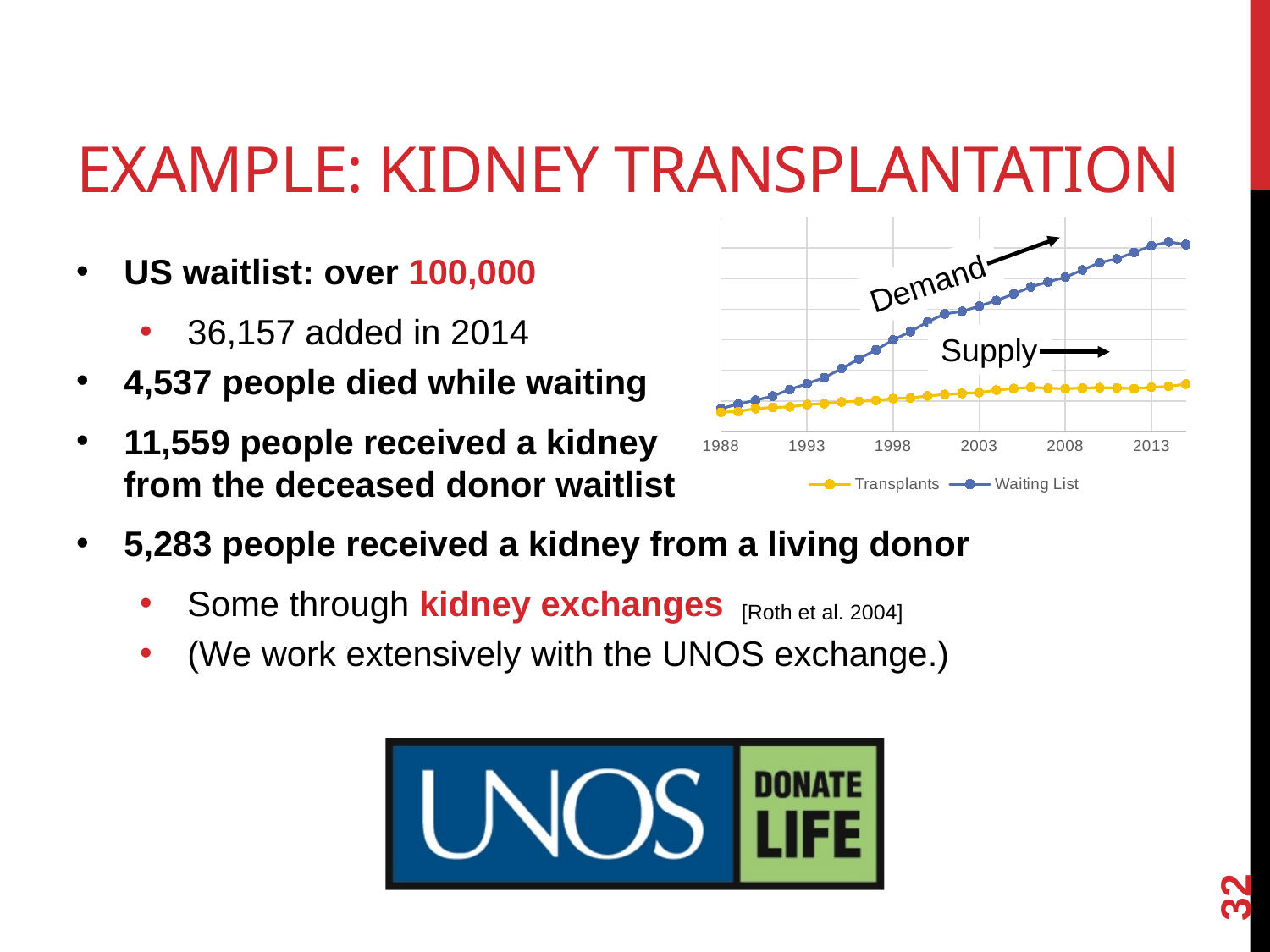
Which series is plotted in yellow? Transplants How many series does the chart's legend list? 2 What is the first year shown on the chart's x axis? 1988 What are the two series named in the chart's legend? Transplants and Waiting List Which series is higher in 2013, Transplants or Waiting List? Waiting List Which series is labelled 'Demand' on the chart? Waiting List Does the Waiting List series rise or fall from 1988 to 2013? rise Does the Transplants series rise or fall from 1988 to 2013? rise What is the last year tick shown on the chart's x axis? 2013 Which series rises more steeply over the period shown, Transplants or Waiting List? Waiting List What kind of chart is shown on the slide? line chart